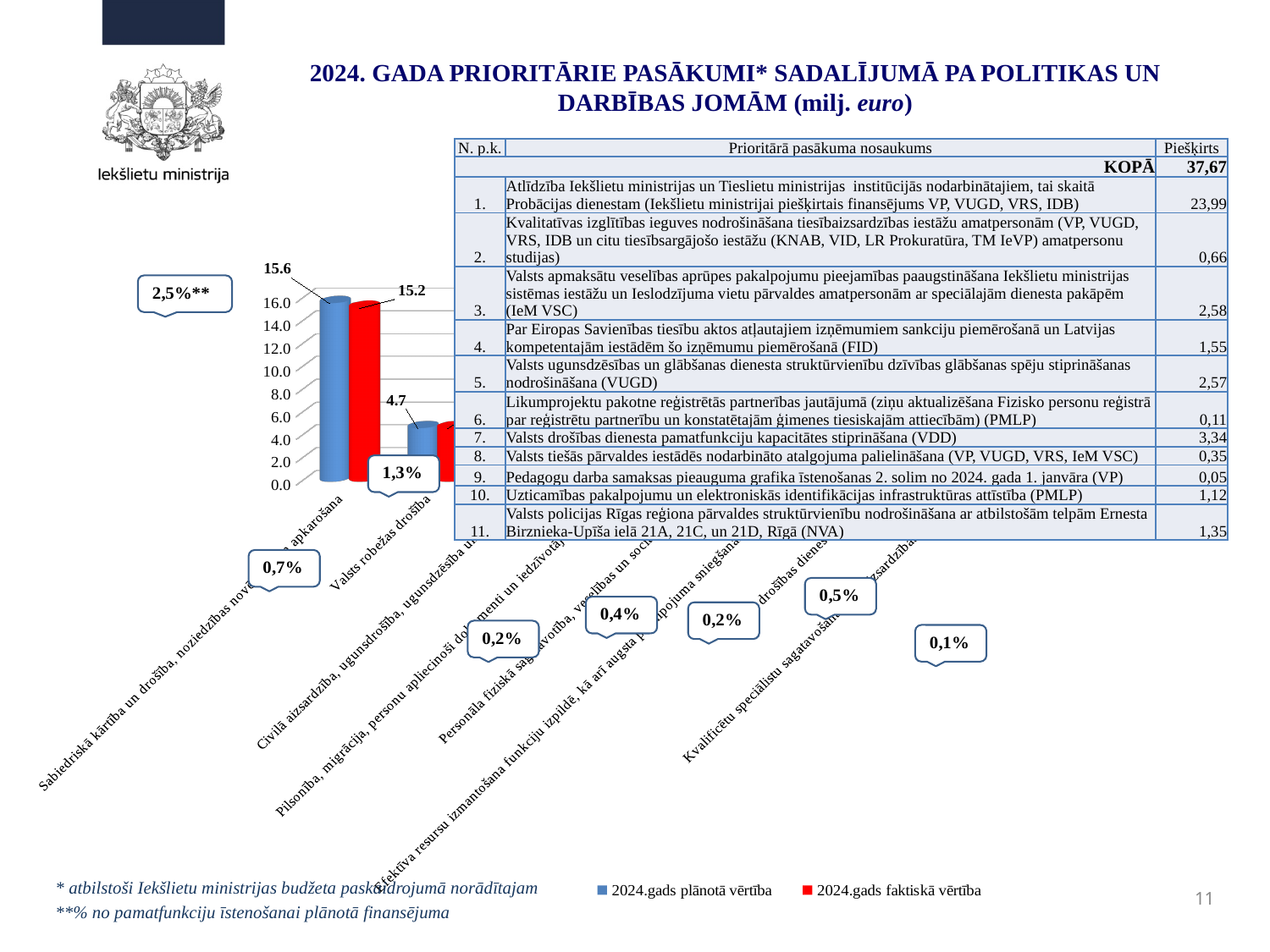
Which colour represents 2024.gads faktiskā vērtība in the chart? red What is the difference between the planned (15.6) and actual (15.2) values for Sabiedriskā kārtība un drošība, noziedzības novēršana un apkarošana? 0.4 How many series does the chart legend list? 2 What is the 2024.gads plānotā vērtība for Valsts robežas drošība? 4.7 What is the 2024.gads faktiskā vērtība for Sabiedriskā kārtība un drošība, noziedzības novēršana un apkarošana? 15.2 What kind of chart is shown on the slide? bar chart For Sabiedriskā kārtība un drošība, noziedzības novēršana un apkarošana, which is larger: the 2024.gads plānotā vērtība or the 2024.gads faktiskā vērtība? 2024.gads plānotā vērtība What is the 2024.gads plānotā vērtība for Sabiedriskā kārtība un drošība, noziedzības novēršana un apkarošana? 15.6 What is the highest tick value shown on the chart's vertical axis? 16.0 Which category has the highest 2024.gads plānotā vērtība? Sabiedriskā kārtība un drošība, noziedzības novēršana un apkarošana Is the 2024.gads faktiskā vērtība for Valsts robežas drošība greater or less than 6.0? less